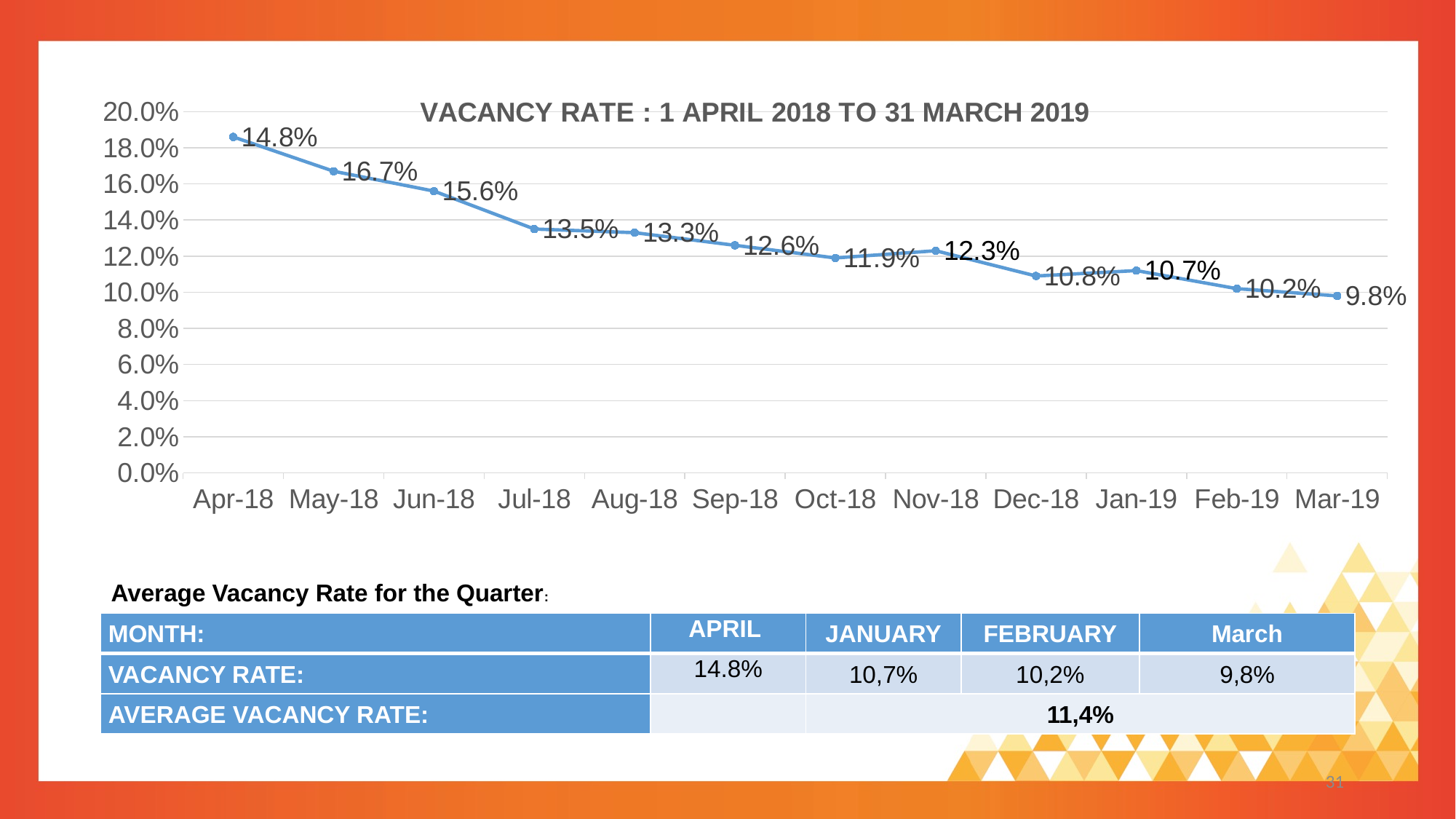
How many months are plotted on the chart? 12 Which is higher, the vacancy rate for Oct-18 or Nov-18? Nov-18 What is the difference between the vacancy rates for Jan-19 and Feb-19? 0.5% What is the vacancy rate for Mar-19? 9.8% What is the vacancy rate for Jul-18? 13.5% What is the difference between the vacancy rates for May-18 and Jun-18? 1.1% Which month has the lowest vacancy rate? Mar-19 What is the vacancy rate for Nov-18? 12.3% What kind of chart is shown? line chart Is the vacancy rate for Sep-18 greater or less than 12.0%? greater What is the vacancy rate for Dec-18? 10.8% Does the vacancy rate generally rise or fall from Apr-18 to Mar-19? fall